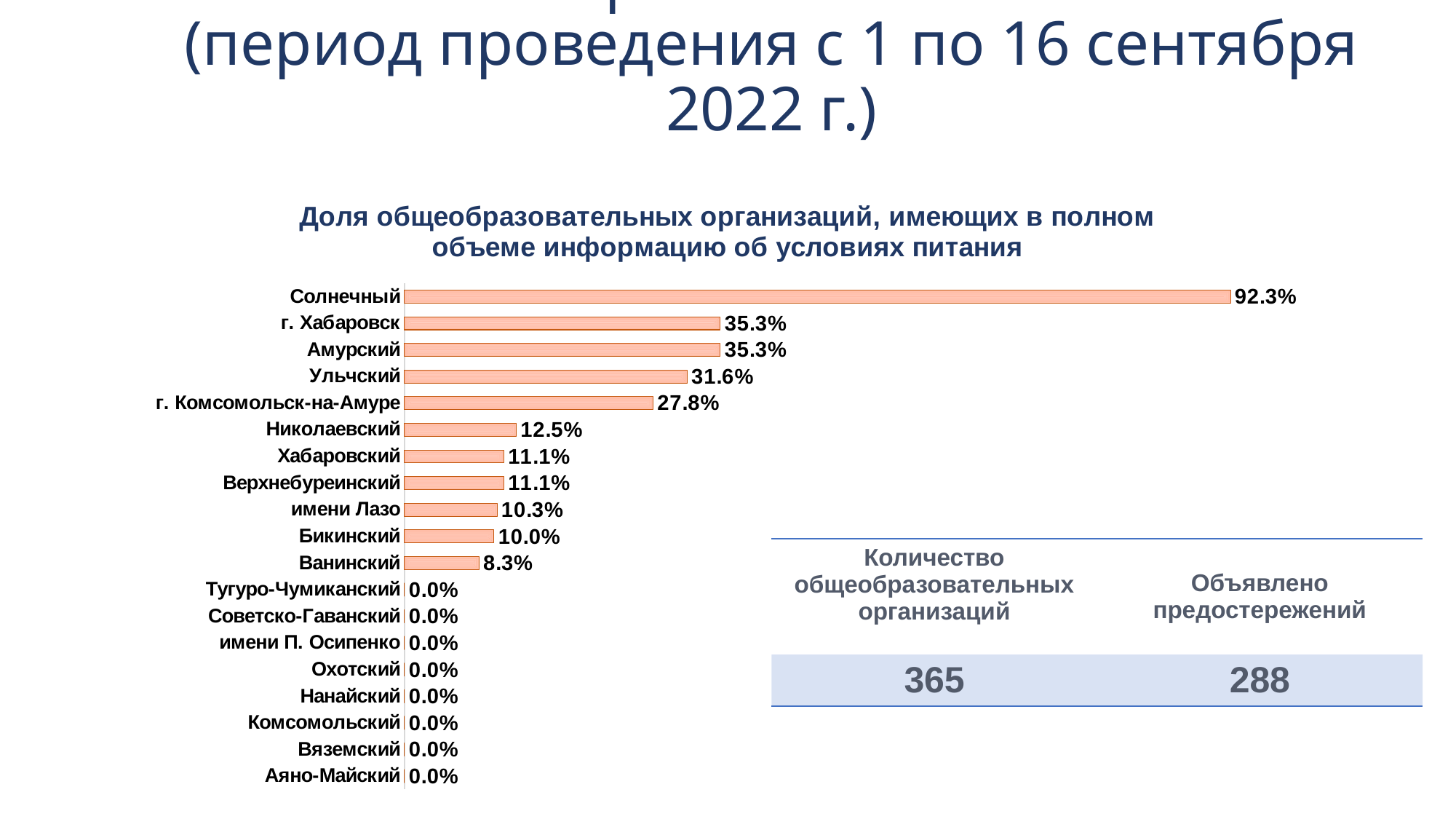
What is the value for Ванинский? 8.3% What is the value for Солнечный? 92.3% What is the value for г. Комсомольск-на-Амуре? 27.8% What is the difference between the values for Солнечный and г. Хабаровск? 57.0% How many categories have a value of 0.0%? 8 What kind of chart is shown on the slide? Bar chart What is the value for Ульчский? 31.6% What is the title of the chart? Доля общеобразовательных организаций, имеющих в полном объеме информацию об условиях питания How many categories are shown in the chart? 19 What is the difference between the values for Николаевский and Бикинский? 2.5% Which category has the highest value? Солнечный Which is larger, the value for Ульчский or the value for г. Комсомольск-на-Амуре? Ульчский